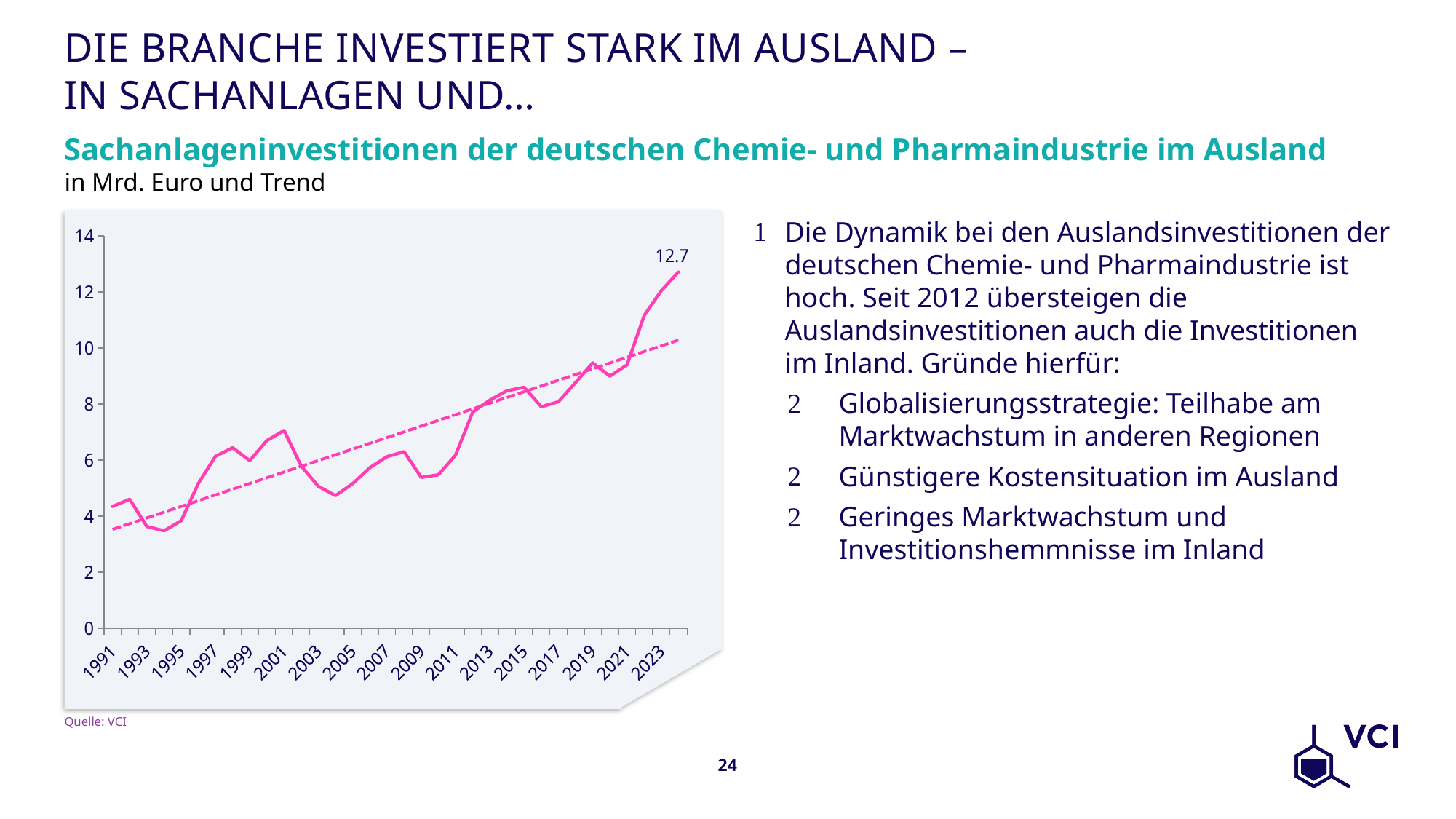
What kind of chart is shown on the slide? line chart Is the value for 2005 greater or less than 6? less Which year has the larger value, 2001 or 2005? 2001 What is the highest value shown on the vertical axis? 14 In what unit are the values of the chart given, according to the subtitle? Mrd. Euro Is the value for 2019 greater or less than 10? less Is the value for 2001 greater or less than 6? greater Does the series generally rise or fall from 1991 to the end of the chart? rise What is the value printed at the last data point of the line? 12.7 Is the highest value of the series at the beginning or at the end of the time axis? at the end